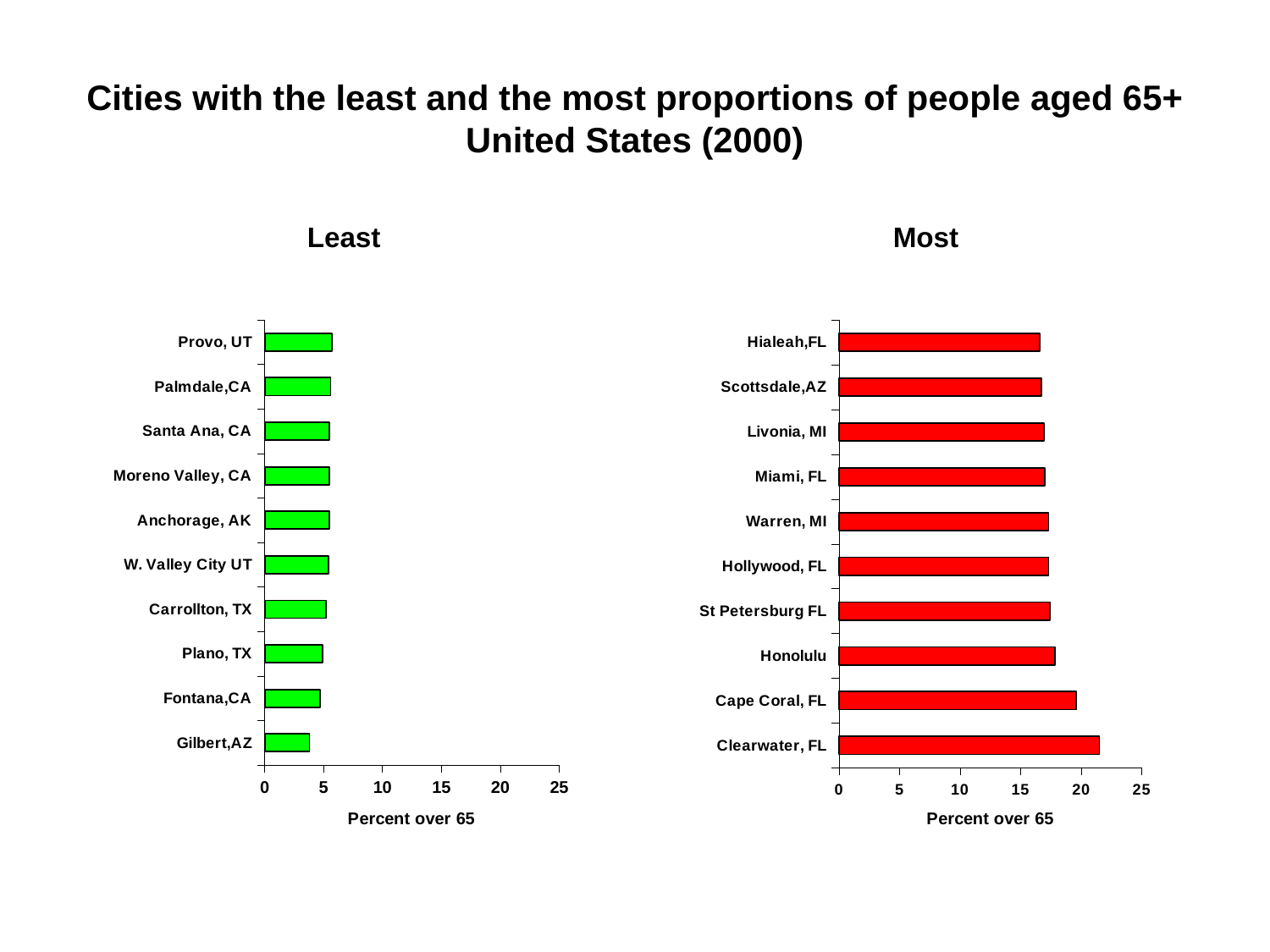
What is the x-axis title of the Least chart? Percent over 65 In the Most chart, is the value for Clearwater, FL greater or less than 20? greater In the Least chart, which has the larger value, Fontana,CA or Gilbert,AZ? Fontana,CA In the Most chart, is the value for Hialeah,FL greater or less than 15? greater How many cities are shown in the Most chart? 10 How many cities are shown in the Least chart? 10 In the Least chart, is the value for Provo, UT greater or less than 5? greater In the Most chart, which has the larger value, Clearwater, FL or Cape Coral, FL? Clearwater, FL In the Most chart, which city has the highest percent over 65? Clearwater, FL In the Least chart, which city has the lowest percent over 65? Gilbert,AZ What kind of chart is the Most chart? Bar chart